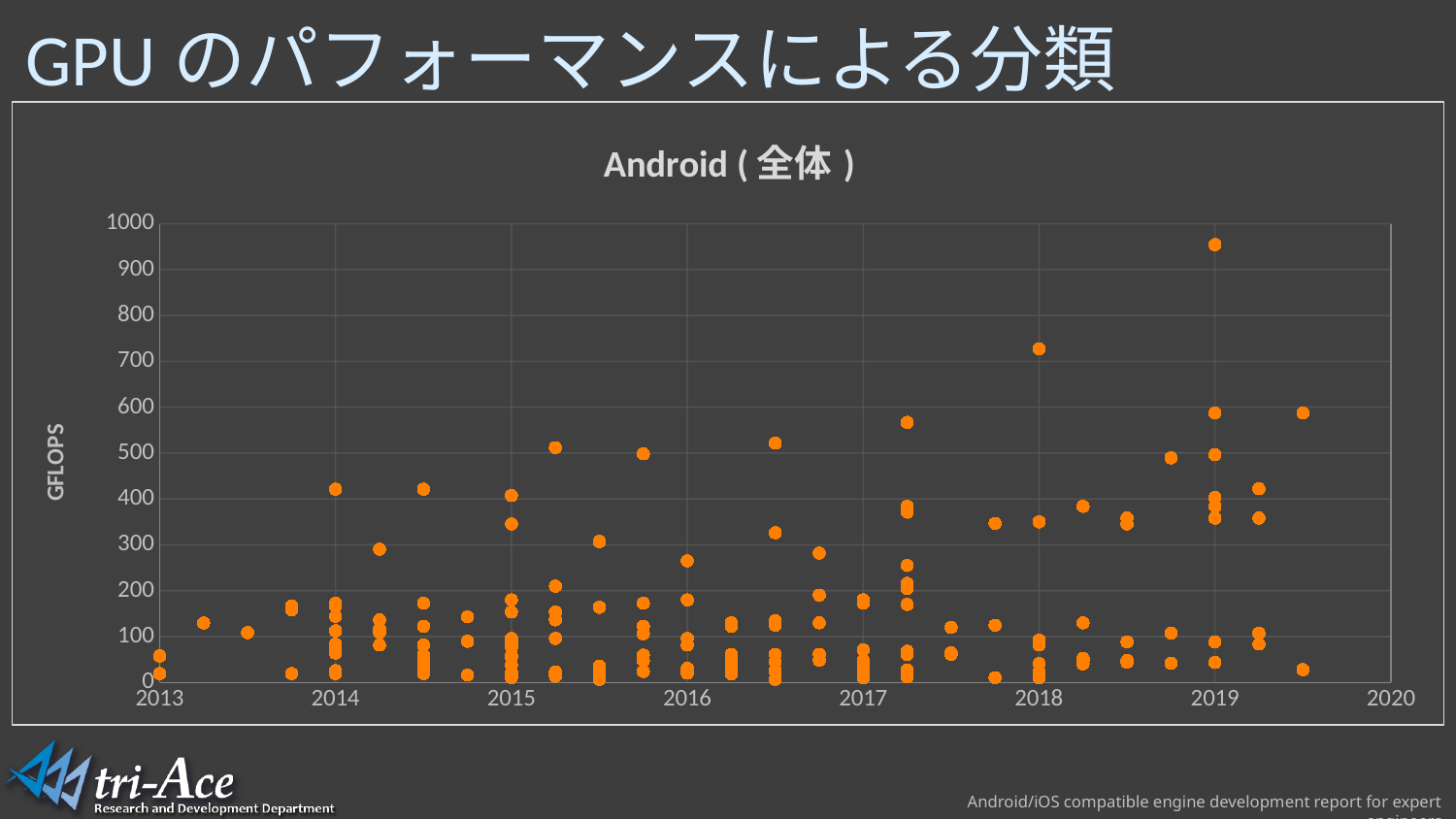
Is the highest plotted value near 2018 greater or less than 700 GFLOPS? greater How many year labels are shown on the x axis? 8 What is the maximum value shown on the vertical axis? 1000 Is the highest plotted value between 2019 and 2020 greater or less than 500 GFLOPS? greater What is the label on the vertical axis of the chart? GFLOPS Around which year on the x axis does the single highest point appear? 2019 What kind of chart is shown on the slide? scatter chart Do the highest GFLOPS values generally rise or fall from 2013 to 2019? rise Is the highest plotted value, near 2019, greater or less than 900 GFLOPS? greater What is the title of the chart? Android ( 全体 )